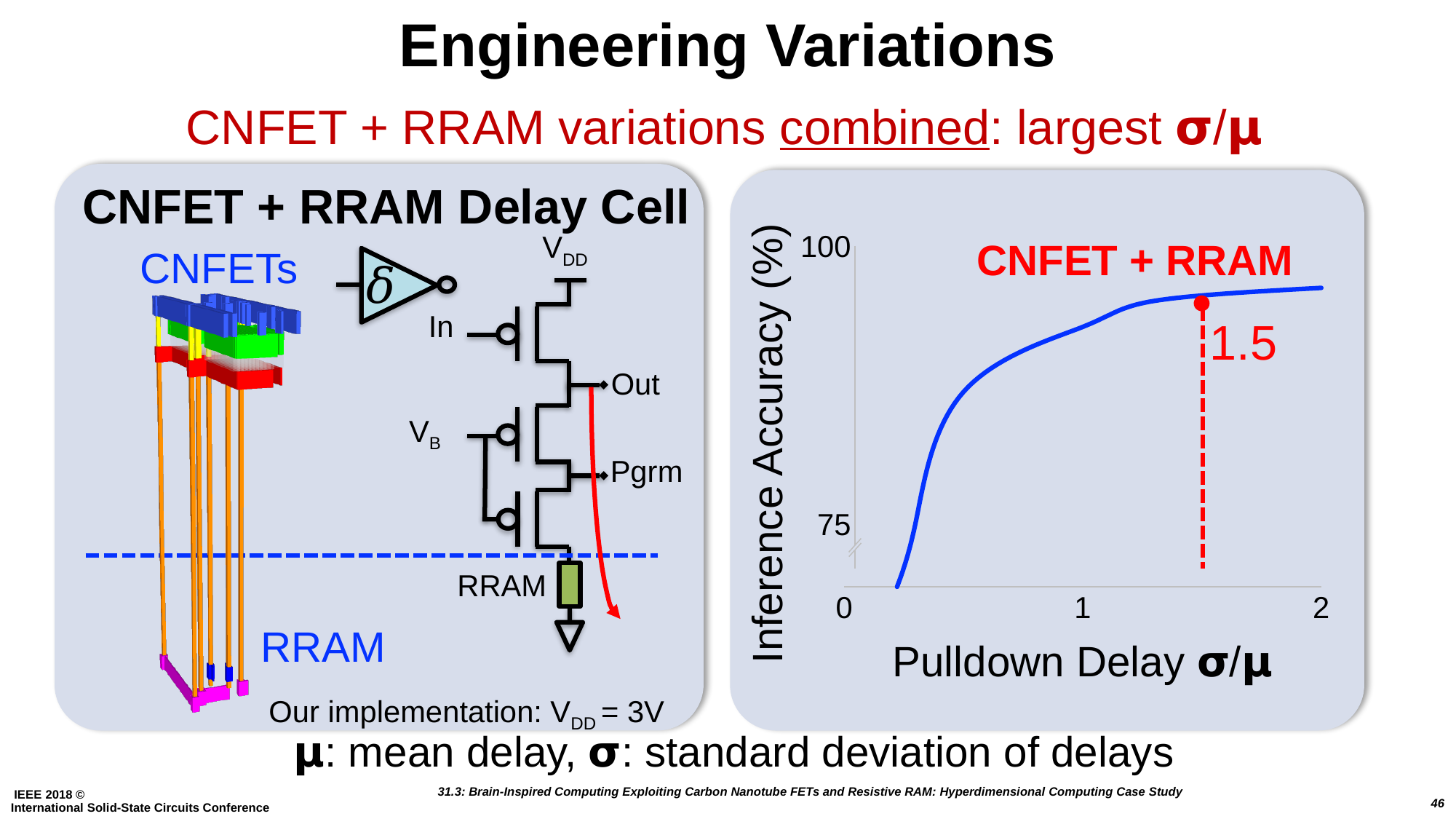
What is the highest tick value shown on the x axis of the chart? 2 What is the label of the x axis of the chart? Pulldown Delay σ/μ At what pulldown delay σ/μ value is the red dashed marker placed on the curve? 1.5 Is the inference accuracy at a pulldown delay σ/μ of 1 greater or less than 75? greater Which is higher: the inference accuracy at a pulldown delay σ/μ of 0.5 or at 1.5? 1.5 Does inference accuracy rise or fall as pulldown delay σ/μ increases along the x axis? rise Is the inference accuracy at a pulldown delay σ/μ of 2 greater or less than 100? less What kind of chart is shown on the right side of the slide? line chart Is the inference accuracy at the leftmost plotted point of the curve greater or less than 75? less What is the label of the y axis of the chart? Inference Accuracy (%) How many data series are plotted in the chart? 1